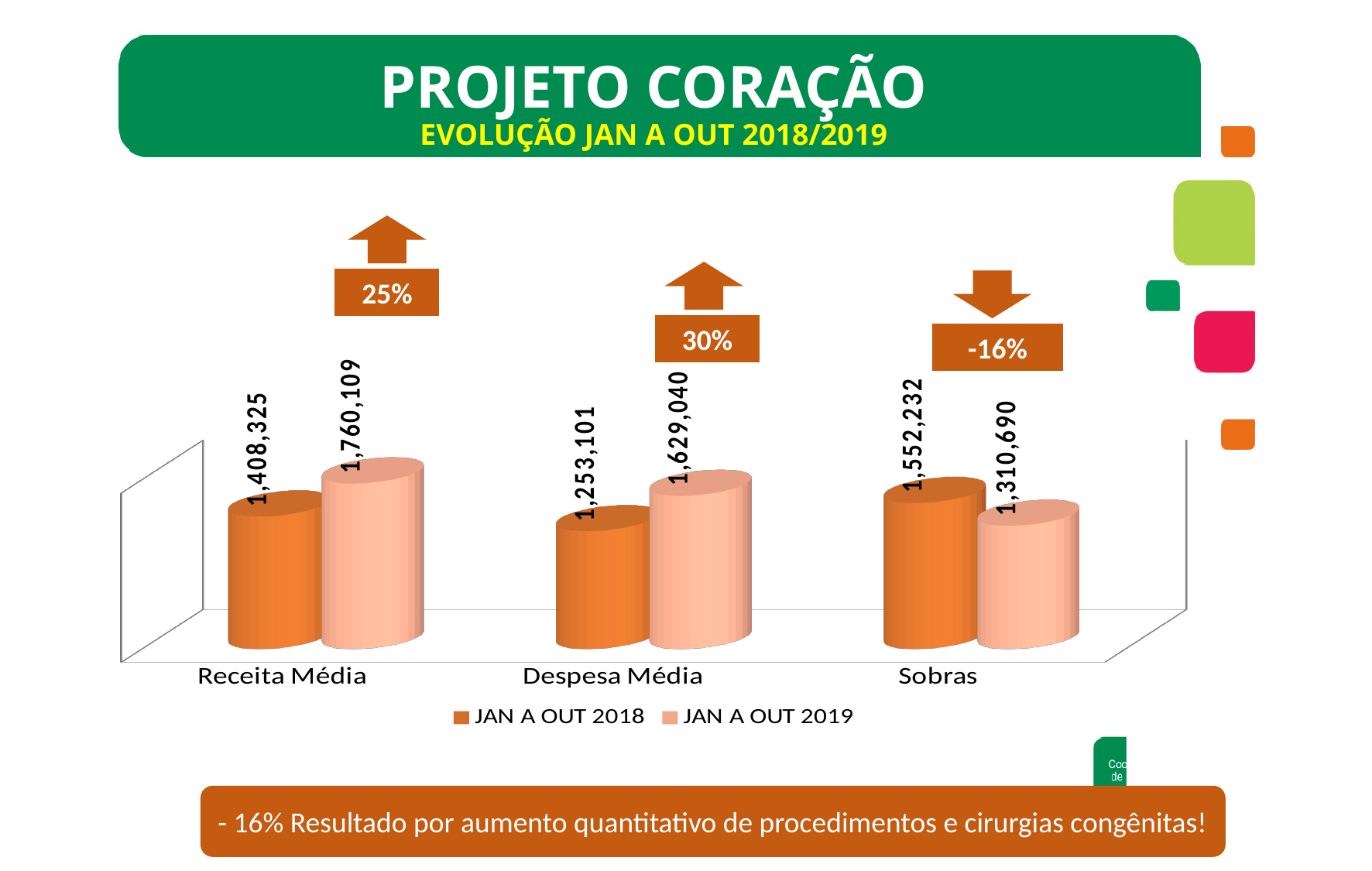
What is the value for Sobras in the JAN A OUT 2018 series? 1,552,232 Which category has the highest value in the JAN A OUT 2019 series? Receita Média For Sobras, which series has the larger value, JAN A OUT 2018 or JAN A OUT 2019? JAN A OUT 2018 How many categories are shown on the x axis of the chart? 3 Which category has the lowest value in the JAN A OUT 2018 series? Despesa Média What kind of chart is shown on the slide? Bar chart What is the value for Despesa Média in the JAN A OUT 2019 series? 1,629,040 How many series does the chart legend list? 2 What is the value for Receita Média in the JAN A OUT 2019 series? 1,760,109 What is the difference between the JAN A OUT 2019 and JAN A OUT 2018 values for Receita Média? 351,784 What is the difference between the JAN A OUT 2018 and JAN A OUT 2019 values for Sobras? 241,542 What is the value for Receita Média in the JAN A OUT 2018 series? 1,408,325